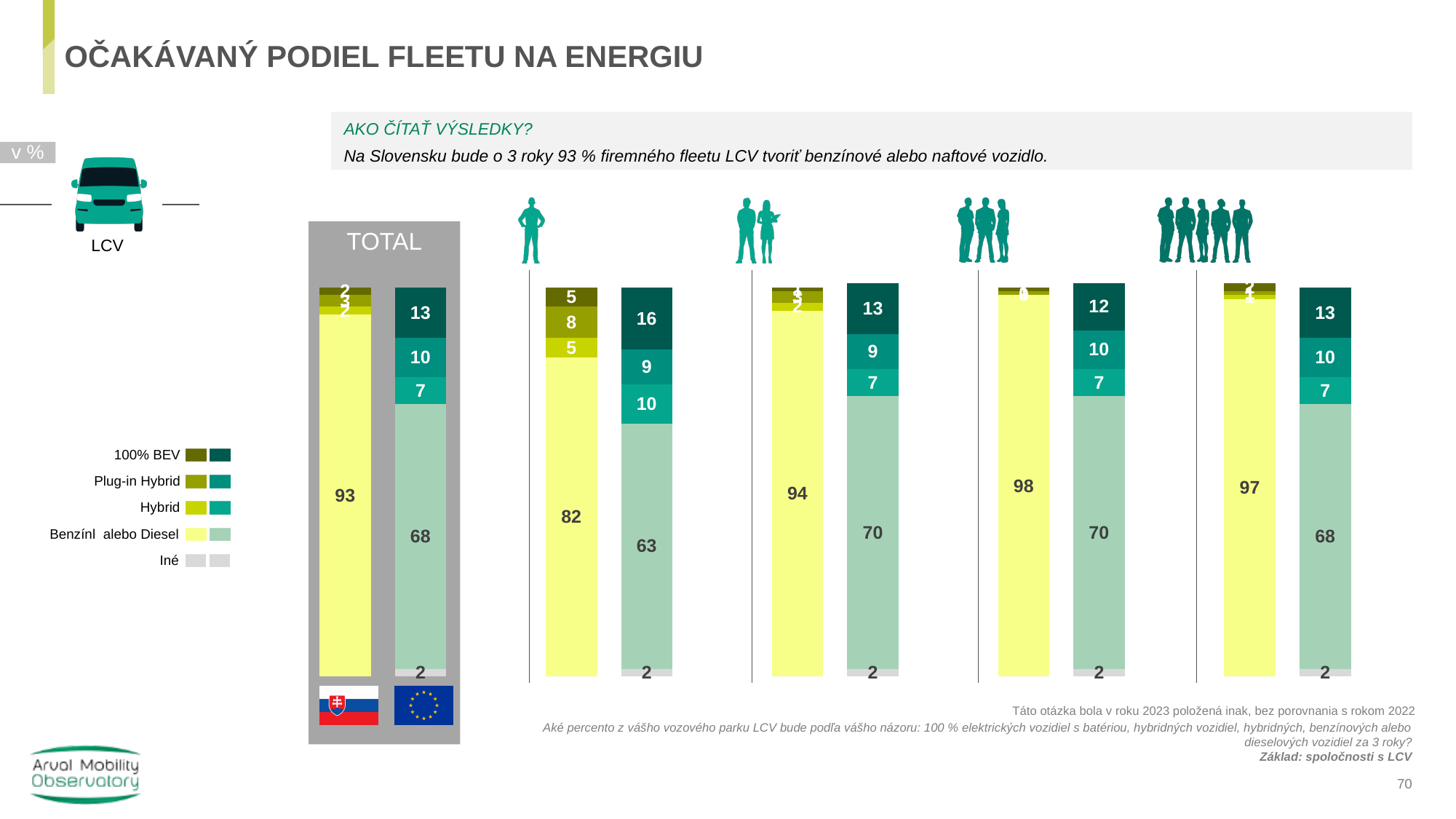
How many categories does the legend list? 5 What kind of chart is used on this slide? Stacked bar chart In the TOTAL chart, what is the Benzín alebo Diesel share for the EU (right) bar? 68 In the first chart to the right of TOTAL (single-person icon), what is the Plug-in Hybrid share for the Slovak bar? 8 In the TOTAL chart, what is the difference between the Slovak and EU Benzín alebo Diesel shares? 25 In the first chart to the right of TOTAL (single-person icon), what is the Benzín alebo Diesel share for the Slovak bar? 82 In the third chart to the right of TOTAL (three-person icon), what is the Benzín alebo Diesel share for the Slovak bar? 98 In the TOTAL chart, what is the Plug-in Hybrid share for the EU bar? 10 In the first chart to the right of TOTAL (single-person icon), what is the 100% BEV share for the EU bar? 16 In the TOTAL chart, what is the 100% BEV share for the EU bar? 13 In the rightmost chart (largest group icon), which bar has the larger Benzín alebo Diesel share, the Slovak bar or the EU bar? Slovak bar In the TOTAL chart, what is the Benzín alebo Diesel share for the Slovak (left) bar? 93